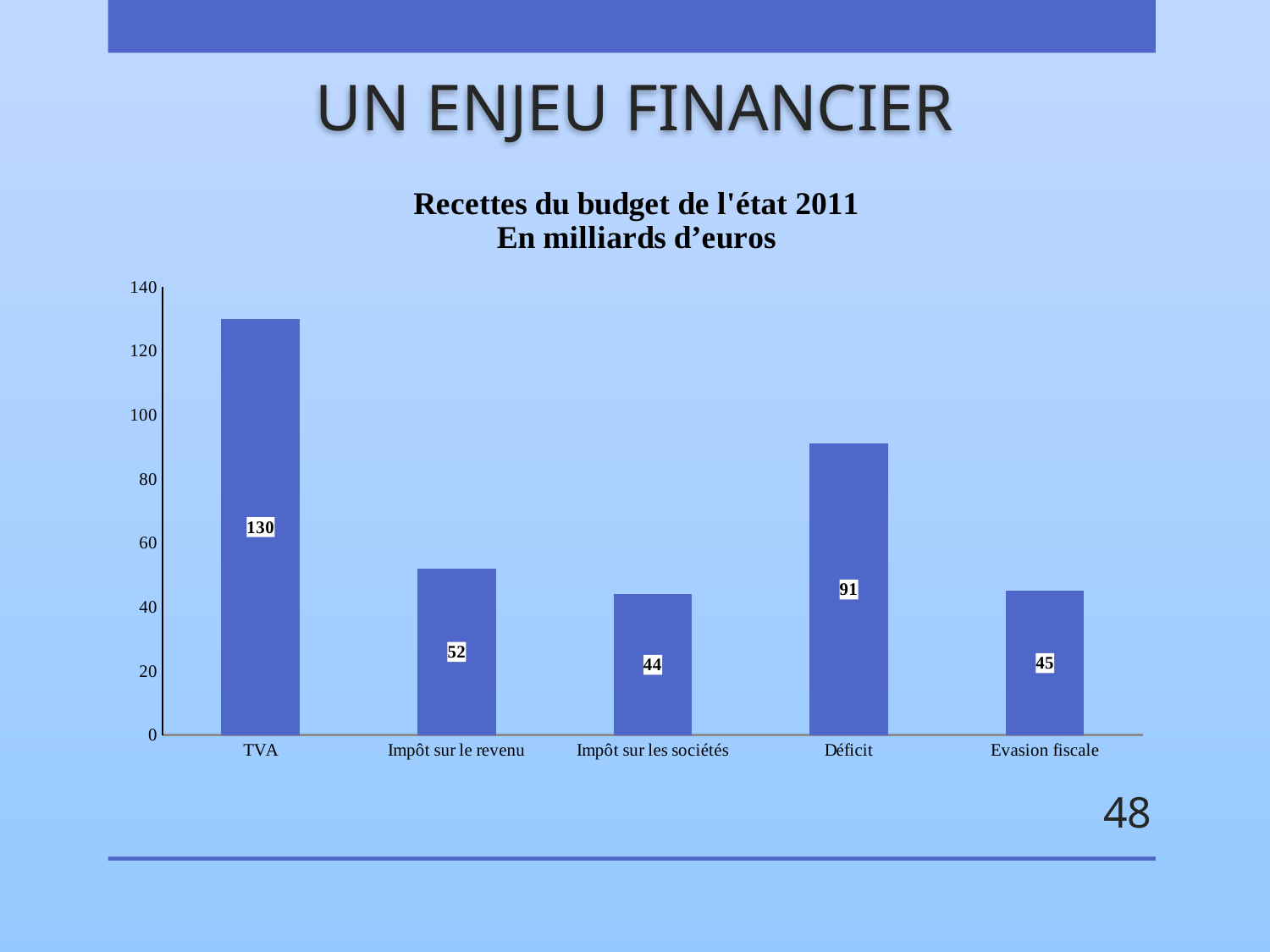
Which is larger, the value for Impôt sur le revenu or the value for Evasion fiscale? Impôt sur le revenu What is the value for Impôt sur le revenu? 52 Which category has the lowest value? Impôt sur les sociétés Which category has the highest value? TVA What is the value for Evasion fiscale? 45 What kind of chart is shown on the slide? bar chart What is the value for TVA? 130 Is the value for Déficit greater or less than 100? less How many categories are shown on the x axis? 5 What is the difference between the values for TVA and Déficit? 39 What is the value for Déficit? 91 What is the title of the chart? Recettes du budget de l'état 2011 En milliards d'euros